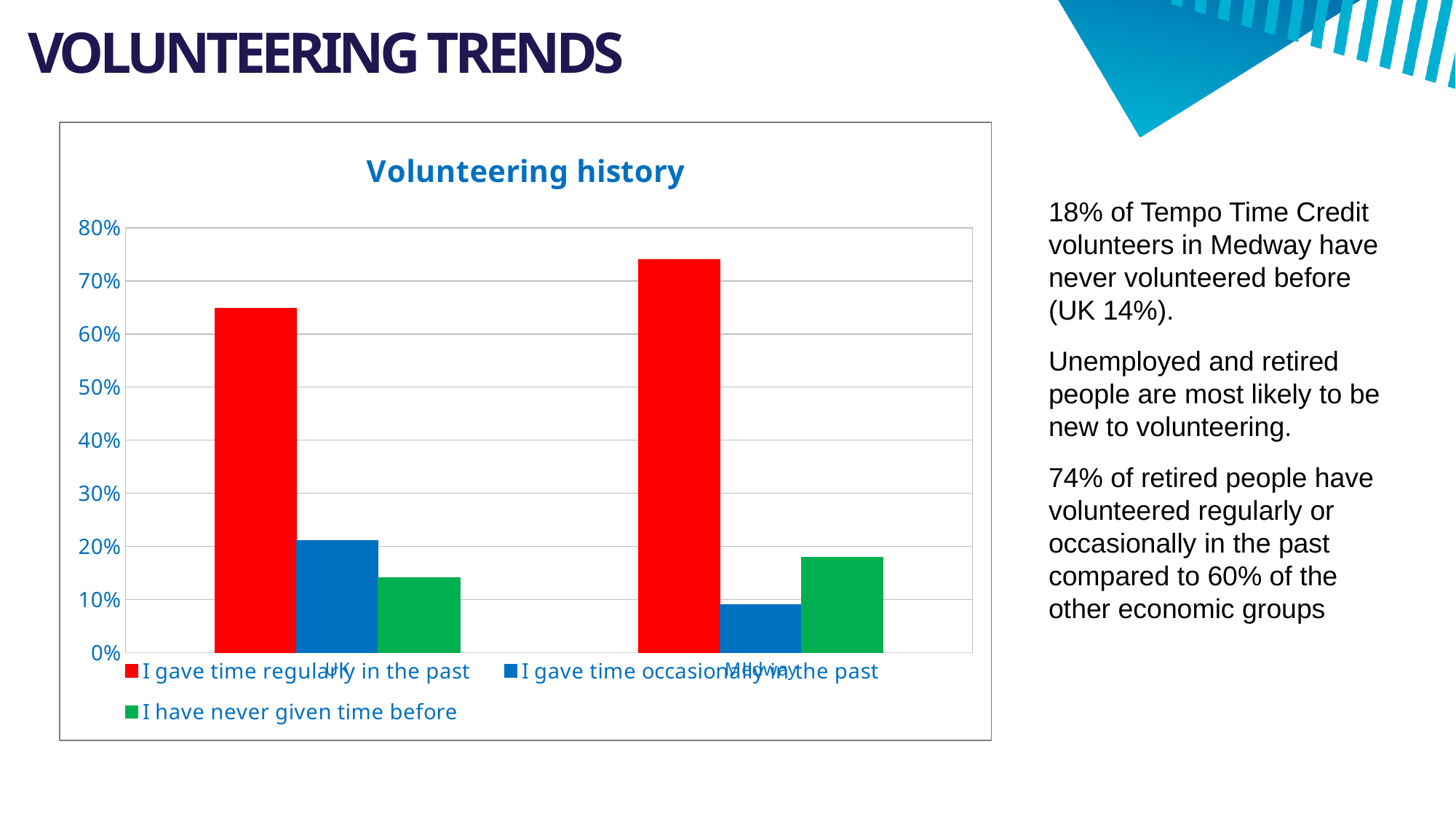
Which is larger: "I gave time occasionally in the past" for UK or for Medway? UK Is the value for "I have never given time before" for UK greater or less than 20%? less What kind of chart is shown under the title "Volunteering history"? bar chart Which series is shown in red in the "Volunteering history" chart? I gave time regularly in the past How many categories are shown on the x axis of the "Volunteering history" chart? 2 Which series is shown in green in the "Volunteering history" chart? I have never given time before Is the value for "I gave time regularly in the past" for UK greater or less than 60%? greater How many series does the legend of the "Volunteering history" chart list? 3 Which is larger: "I gave time regularly in the past" for UK or for Medway? Medway Which series has the lowest value for Medway in the "Volunteering history" chart? I gave time occasionally in the past Is the value for "I gave time regularly in the past" for Medway greater or less than 70%? greater